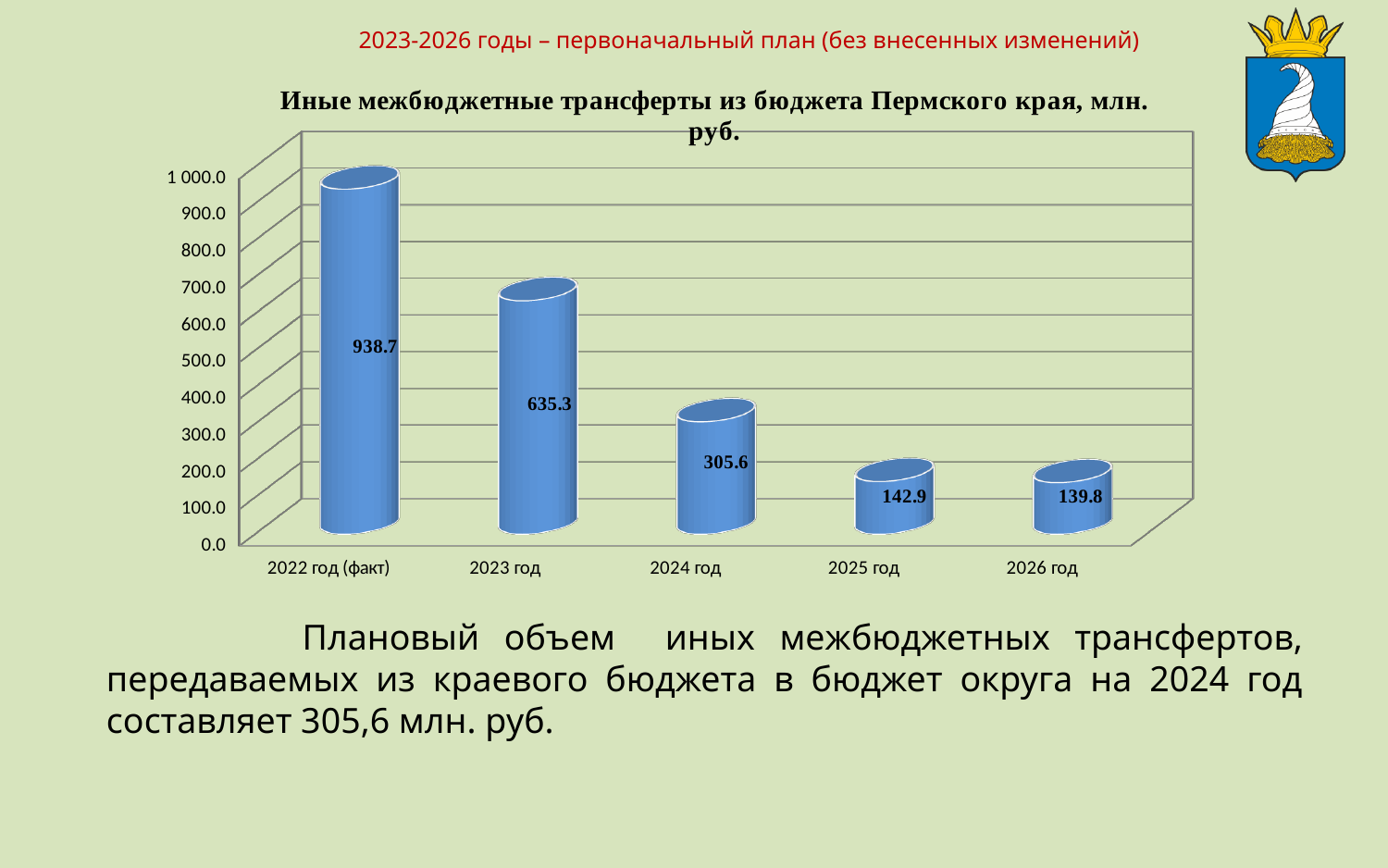
How many categories are shown on the x axis? 5 What is the difference between the values for 2023 год and 2024 год? 329.7 Which is larger, the value for 2023 год or the value for 2025 год? 2023 год What is the value for 2024 год? 305.6 Which category has the highest value? 2022 год (факт) Do the values rise or fall from 2022 год (факт) to 2026 год? fall Is the value for 2023 год greater or less than 600.0? greater What kind of chart is shown on the slide? bar chart What is the title of the chart? Иные межбюджетные трансферты из бюджета Пермского края, млн. руб. Which category has the lowest value? 2026 год What is the value for 2022 год (факт)? 938.7 What is the value for 2026 год? 139.8